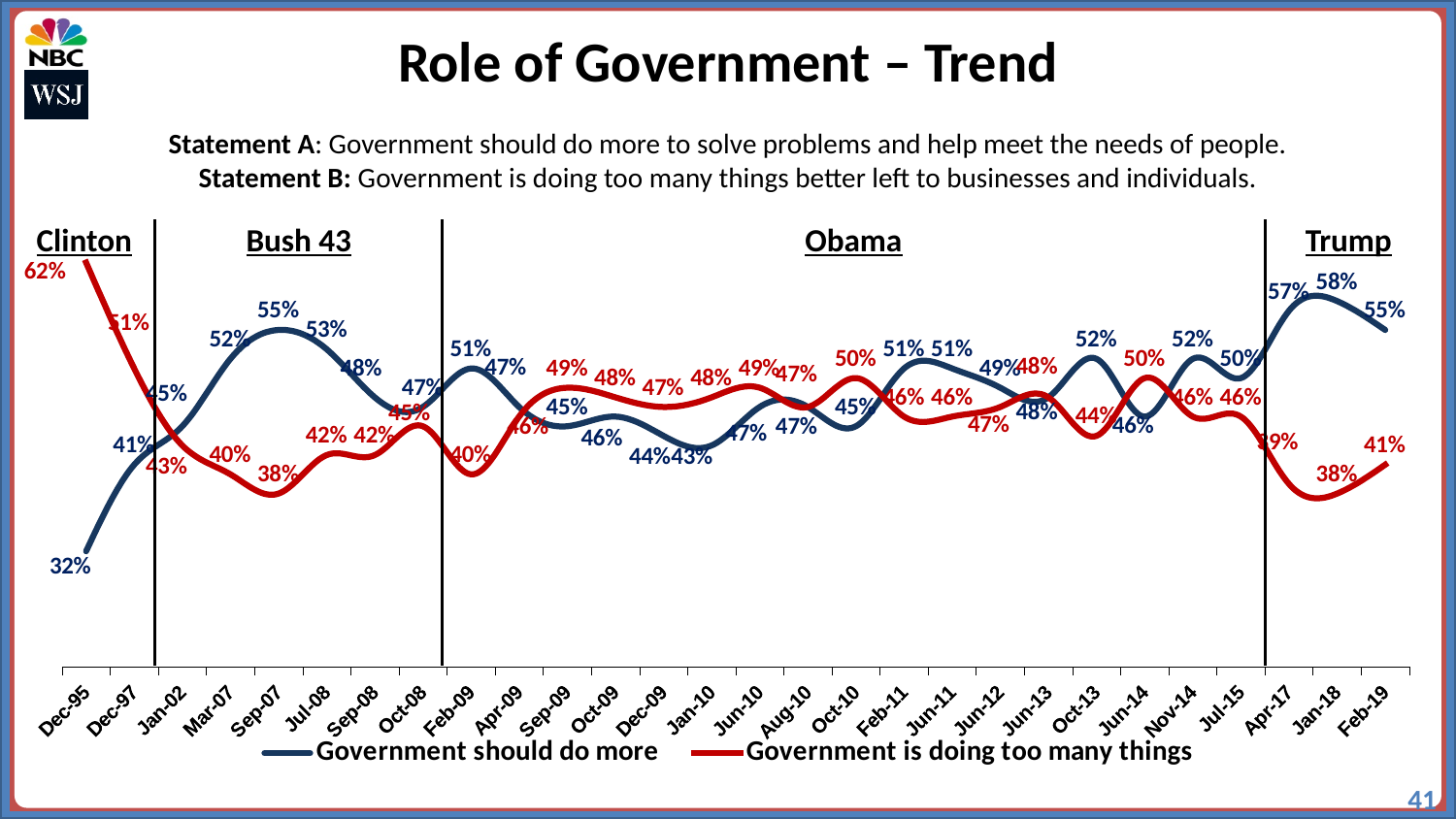
What is the value for "Government is doing too many things" at Feb-19? 41% What is the value for "Government is doing too many things" at Dec-95? 62% At which date does "Government should do more" reach its highest value? Jan-18 At Feb-19, which series has the larger value? Government should do more What is the difference between the two series at Dec-95? 30 percentage points What kind of chart is shown on the slide? Line chart At which date does "Government is doing too many things" reach its highest value? Dec-95 How many series does the legend list? 2 What is the value for "Government should do more" at Jan-18? 58% At which date does "Government should do more" have its lowest value? Dec-95 Does the "Government is doing too many things" line rise or fall from Dec-95 to Sep-07? Fall What is the value for "Government should do more" at Dec-95? 32%